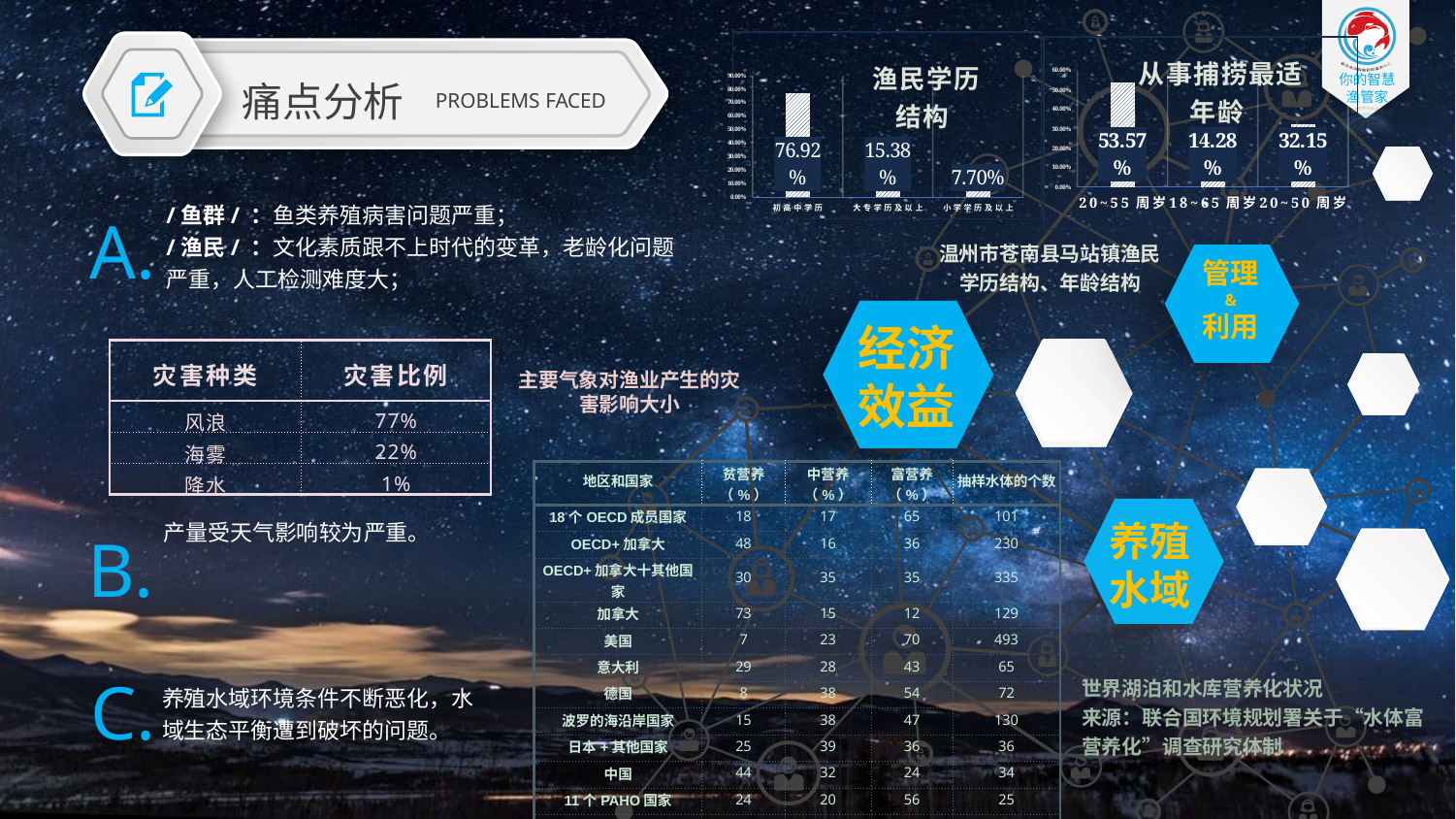
What kind of chart is the 渔民学历结构 chart? bar chart In the 渔民学历结构 chart, what is the value for 小学学历及以上? 7.70% In the 从事捕捞最适年龄 chart, which is larger: the value for 20~50 周岁 or the value for 18~65 周岁? 20~50 周岁 In the 渔民学历结构 chart, what is the difference between the values for 初高中学历 and 大专学历及以上? 61.54% In the 渔民学历结构 chart, what is the value for 初高中学历? 76.92% In the 从事捕捞最适年龄 chart, what is the value for 20~55 周岁? 53.57% In the 渔民学历结构 chart, what is the value for 大专学历及以上? 15.38% In the 渔民学历结构 chart, which category has the highest value? 初高中学历 How many categories are shown in the 渔民学历结构 chart? 3 In the 从事捕捞最适年龄 chart, which category has the highest value? 20~55 周岁 In the 渔民学历结构 chart, which category has the lowest value? 小学学历及以上 In the 从事捕捞最适年龄 chart, what is the value for 18~65 周岁? 14.28%